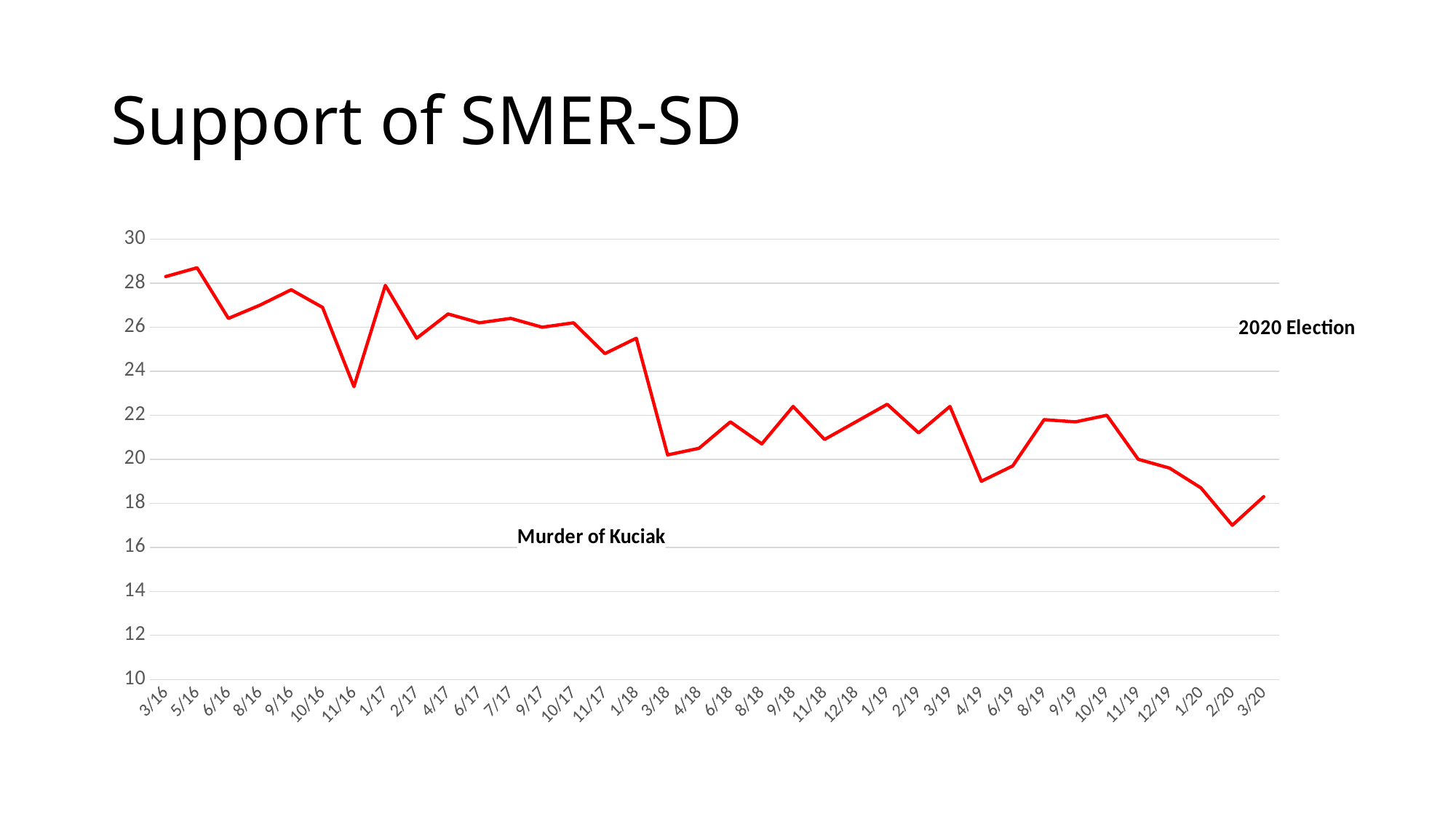
Which is larger, the value for 1/17 or the value for 3/18? 1/17 Is the value for 11/16 greater or less than 26? less Is the value for 3/18 greater or less than 22? less What event is annotated on the chart near the 10/17 to 11/17 area? Murder of Kuciak Which date has the lowest support value? 2/20 Is the value for 2/20 greater or less than 18? less What is the title of the chart? Support of SMER-SD Overall, do the values rise or fall from 3/16 to 3/20? fall Which date has the highest support value? 5/16 How many data points are plotted along the x axis? 36 What kind of chart is shown on the slide? line chart